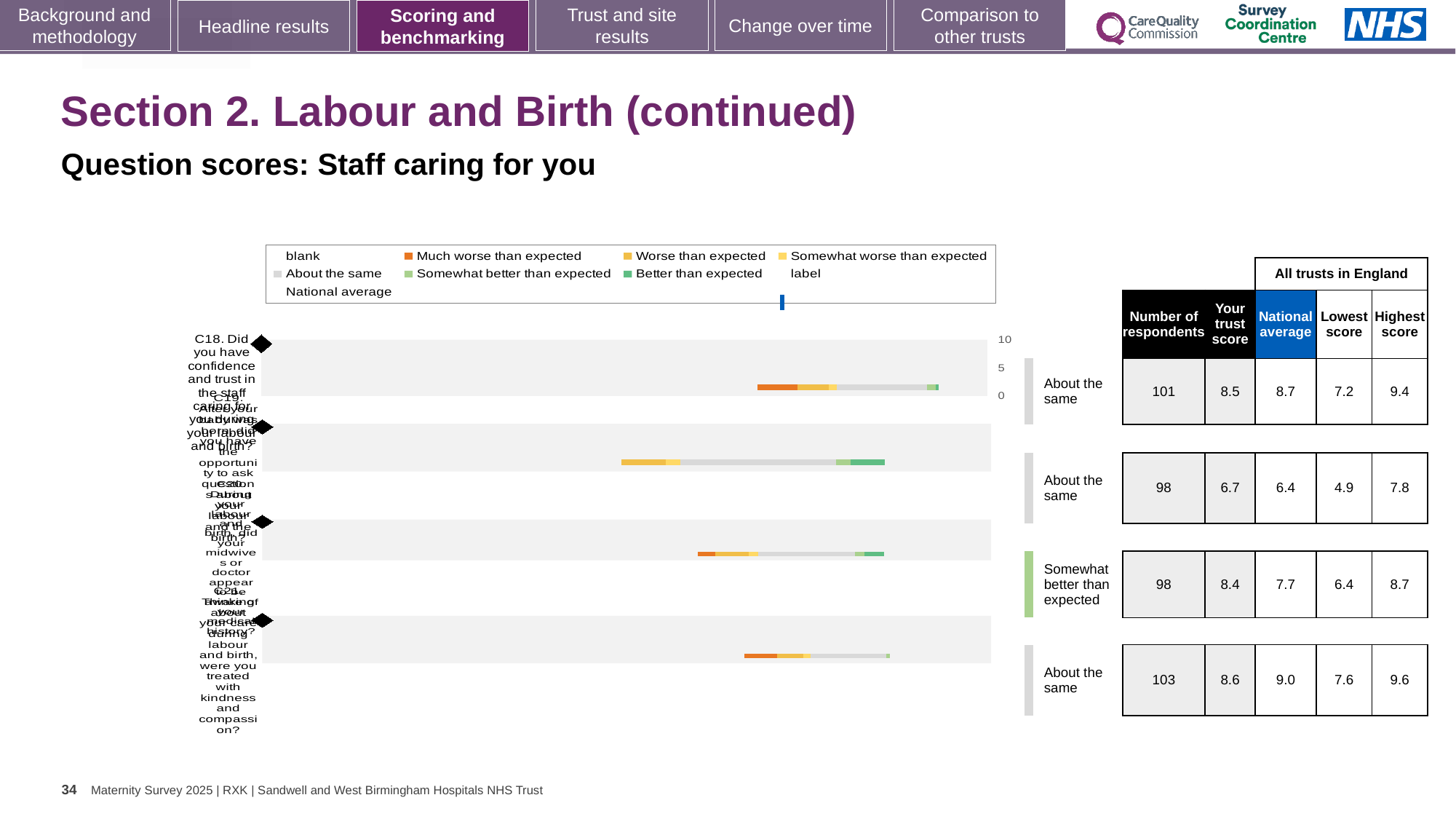
Which row has the highest 'Your trust score'? the fourth row (C21), 8.6 How many respondents are listed for the first row (C18)? 101 How many question rows are plotted in the chart? 4 What is the 'Your trust score' for the first row (C18, confidence and trust in the staff caring for you)? 8.5 Which row has the lowest 'Lowest score' value? the second row (C19), 4.9 Which row is rated 'Somewhat better than expected'? the third row (C20) What is the highest score among all trusts in England for the third row (C20)? 8.7 What kind of chart is shown on the slide? bar chart For the second row (C19), is the trust score or the national average larger? the trust score (6.7) What is the difference between the national average and the trust score for the first row (C18)? 0.2 What colour does the legend use for 'Much worse than expected'? orange What is the national average for the second row (C19)? 6.4